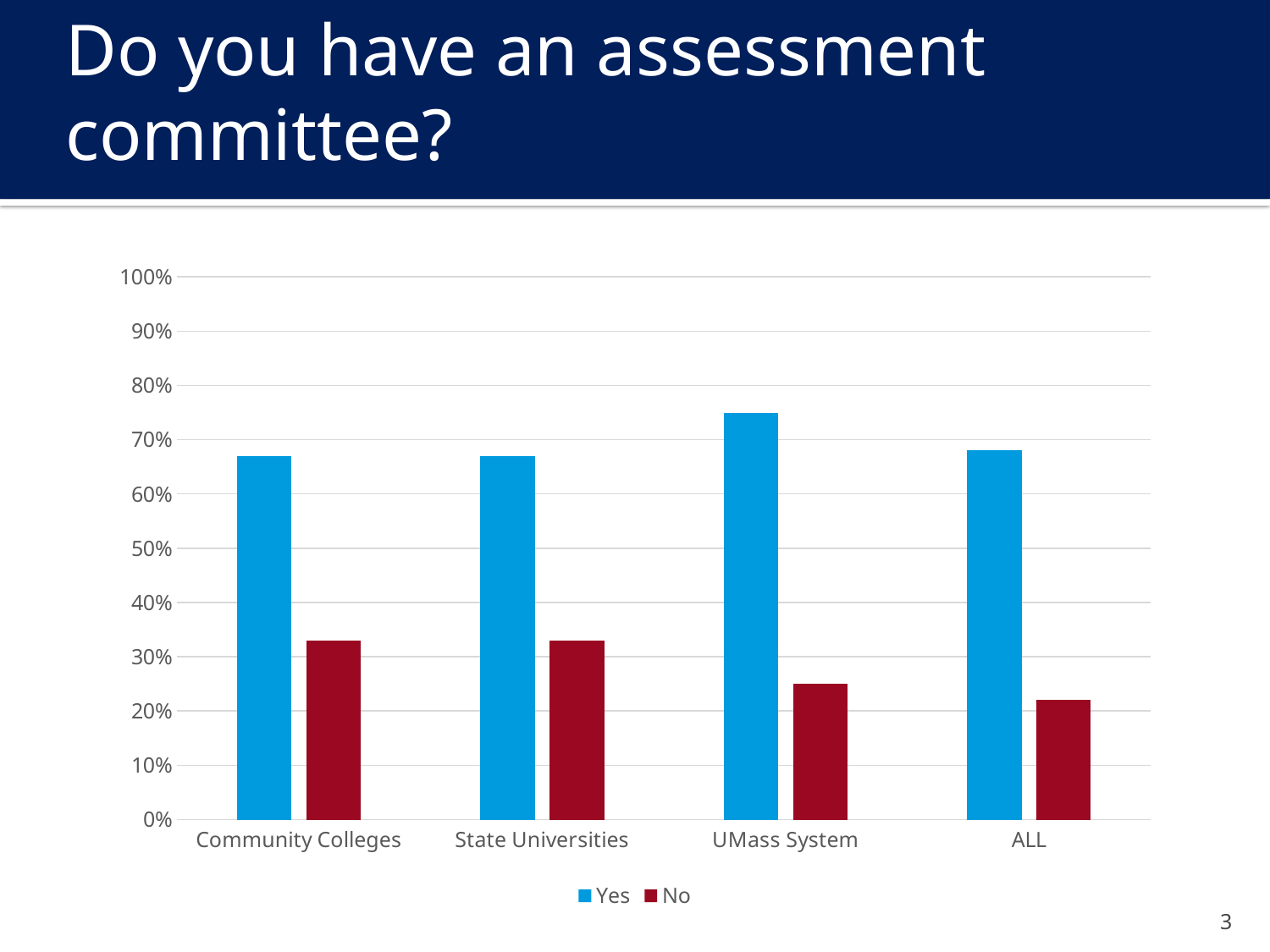
Is the No value for ALL greater or less than 30%? less Which category has the highest Yes value? UMass System What kind of chart is shown on the slide? bar chart Is the Yes value for State Universities greater or less than 80%? less What colour are the No bars? dark red How many series does the legend list? 2 Which is larger, the Yes value for UMass System or the Yes value for State Universities? UMass System How many categories are shown on the x axis? 4 Is the Yes value for Community Colleges greater or less than 60%? greater For UMass System, which is larger, the Yes value or the No value? Yes